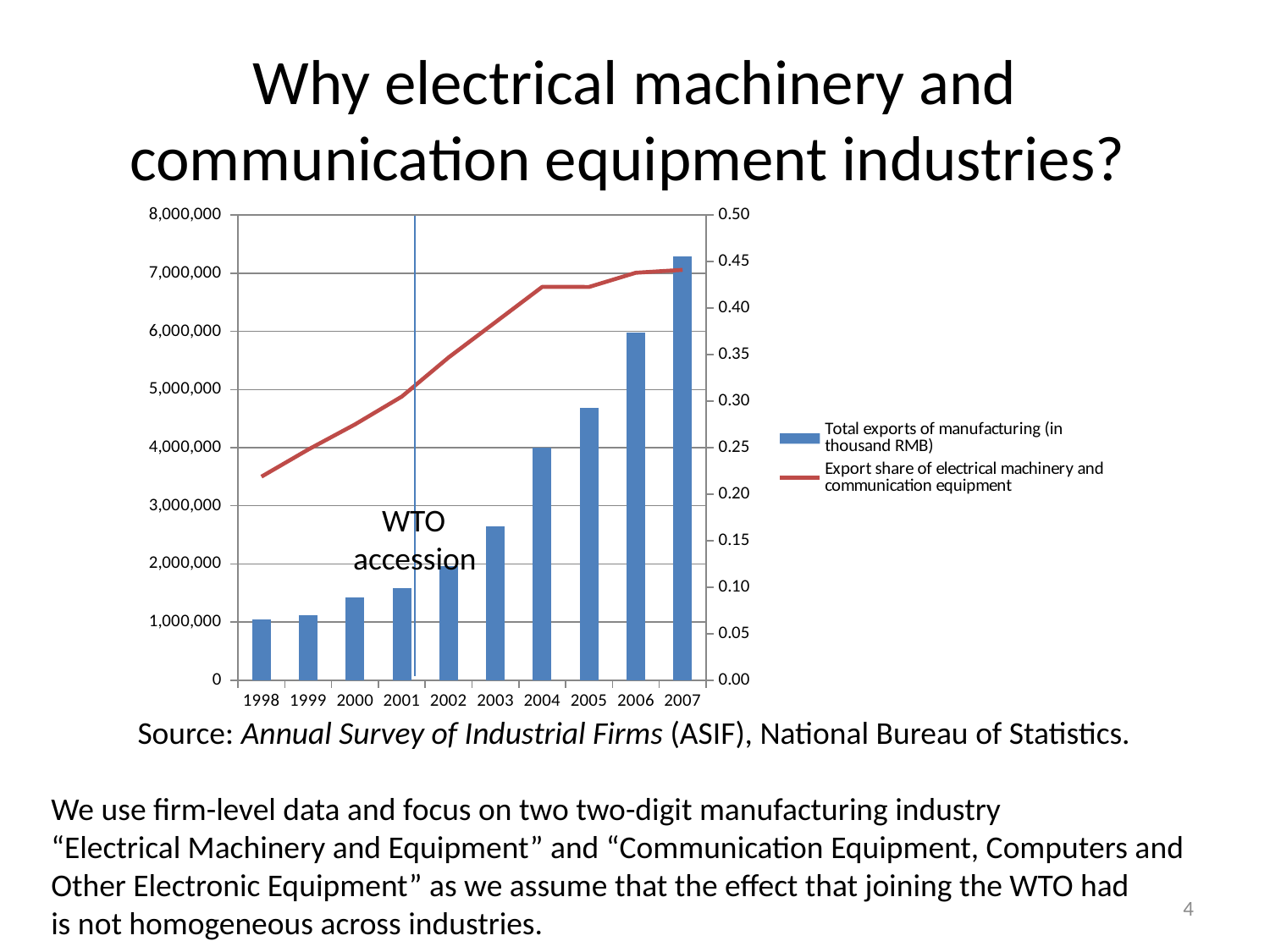
Which year has the lowest total exports of manufacturing? 1998 Is the export share of electrical machinery and communication equipment in 1998 greater or less than 0.25? less Is the total exports of manufacturing bar for 2007 greater or less than 7,000,000? greater Is the total exports of manufacturing bar for 1998 greater or less than 2,000,000? less How many years are shown on the x axis of the chart? 10 Does the export share of electrical machinery and communication equipment rise or fall from 1998 to 2007? rise What event does the vertical line on the chart mark? WTO accession How many series does the chart legend list? 2 Which year has the highest total exports of manufacturing? 2007 Which year has larger total exports of manufacturing, 2004 or 2006? 2006